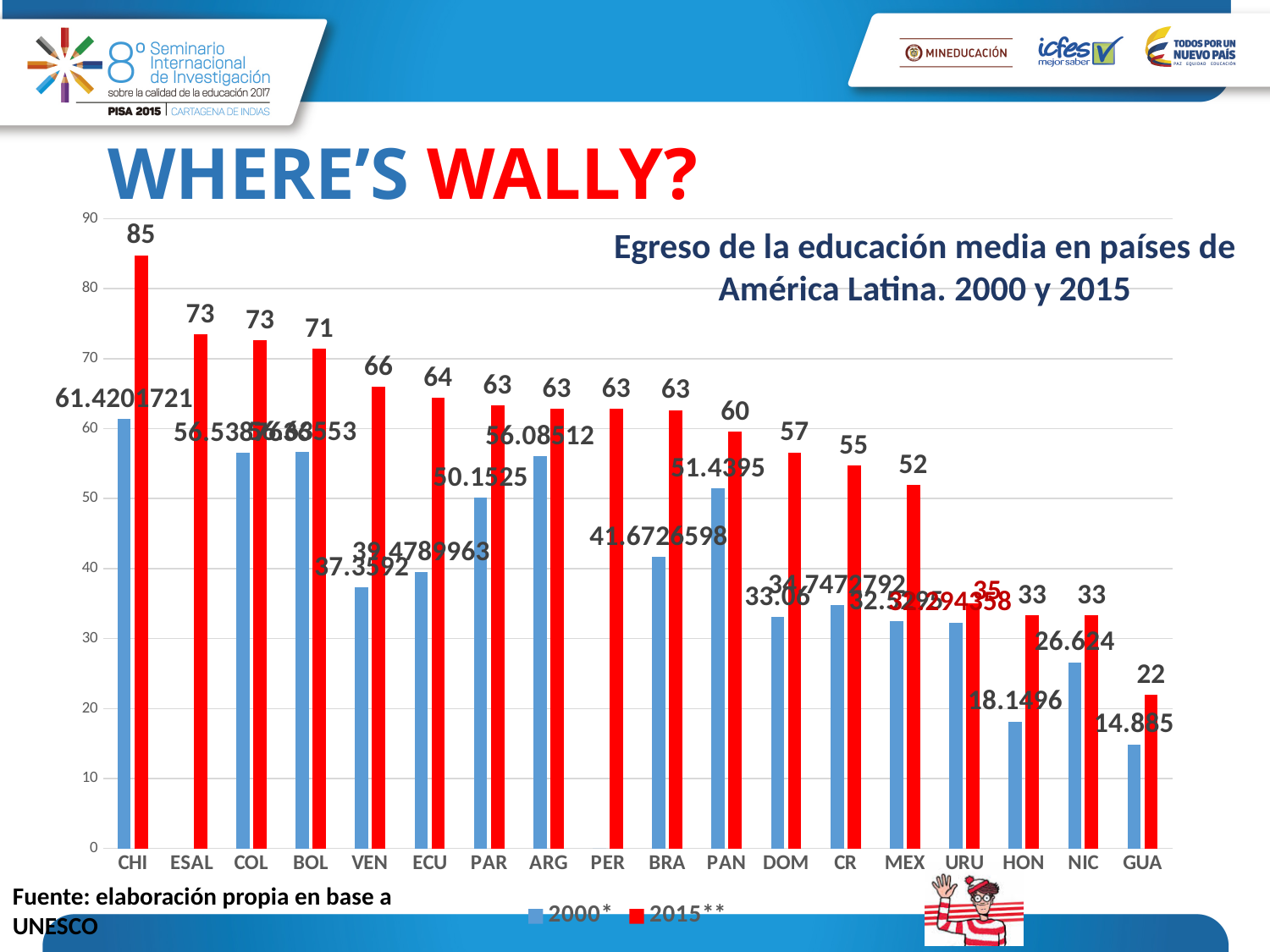
How many countries are shown on the x axis? 18 Which has the larger 2015** value, VEN or ECU? VEN What type of chart is shown on the slide? bar chart Which country has the highest 2015** value? CHI How many series does the legend list? 2 What is the 2015** value for GUA? 22 What is the difference between the 2015** values for CHI and ESAL? 12 What is the 2000* value for HON? 18.1496 Is the 2000* value for VEN greater or less than 40? less Which country has the lowest 2015** value? GUA What is the 2015** value for MEX? 52 What is the 2015** value for CHI? 85